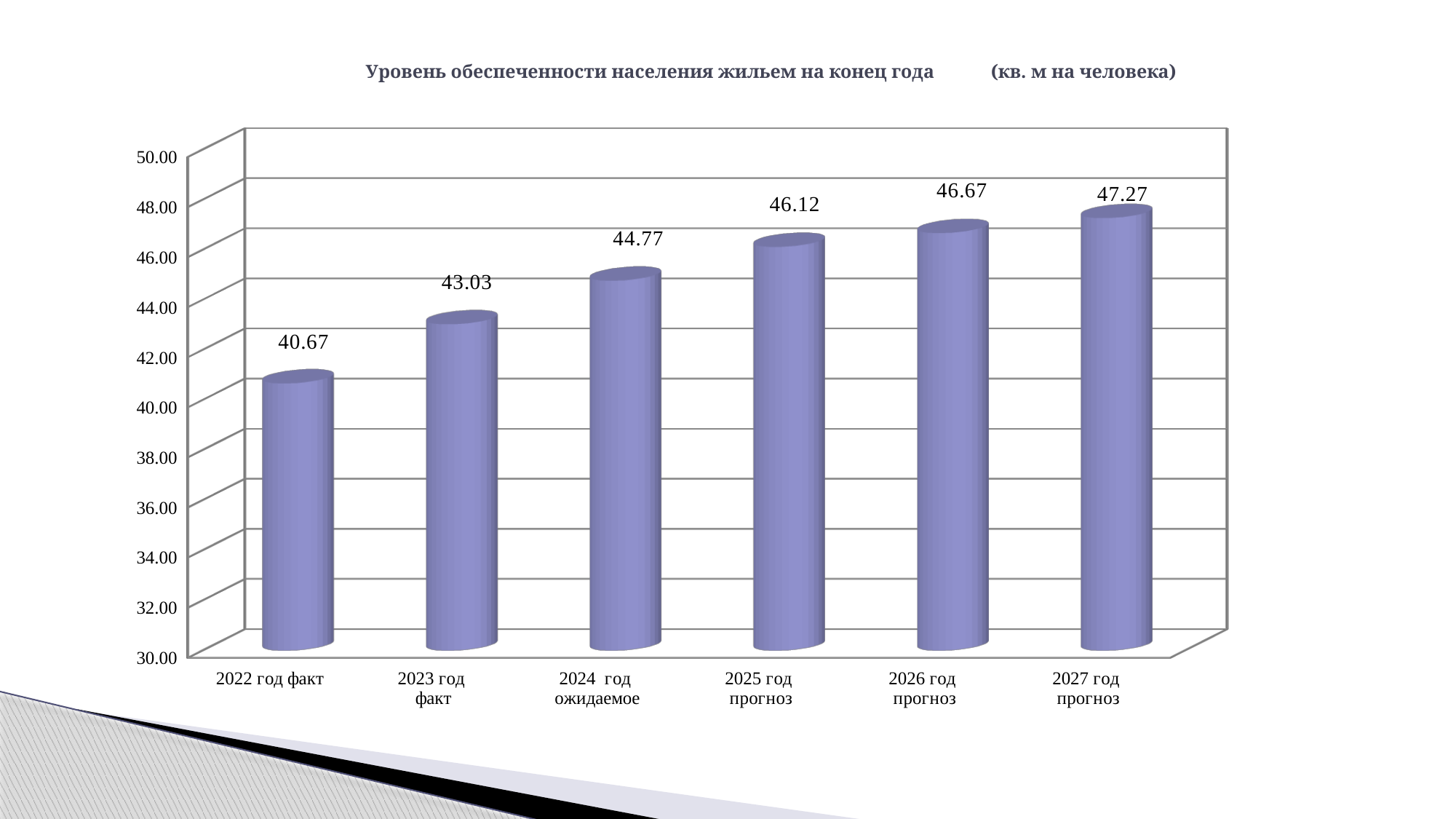
Which category has the lowest value? 2022 год факт Which is larger, the value for 2025 год прогноз or 2024 год ожидаемое? 2025 год прогноз Which category has the highest value? 2027 год прогноз Do the values rise or fall from 2022 to 2027? rise Is the value for 2026 год прогноз greater or less than 46.00? greater What is the difference between the values for 2023 год факт and 2022 год факт? 2.36 What is the value for 2027 год прогноз? 47.27 How many categories are shown on the x axis? 6 What kind of chart is this? bar chart What is the value for 2022 год факт? 40.67 What is the value for 2024 год ожидаемое? 44.77 What is the difference between the values for 2027 год прогноз and 2026 год прогноз? 0.60